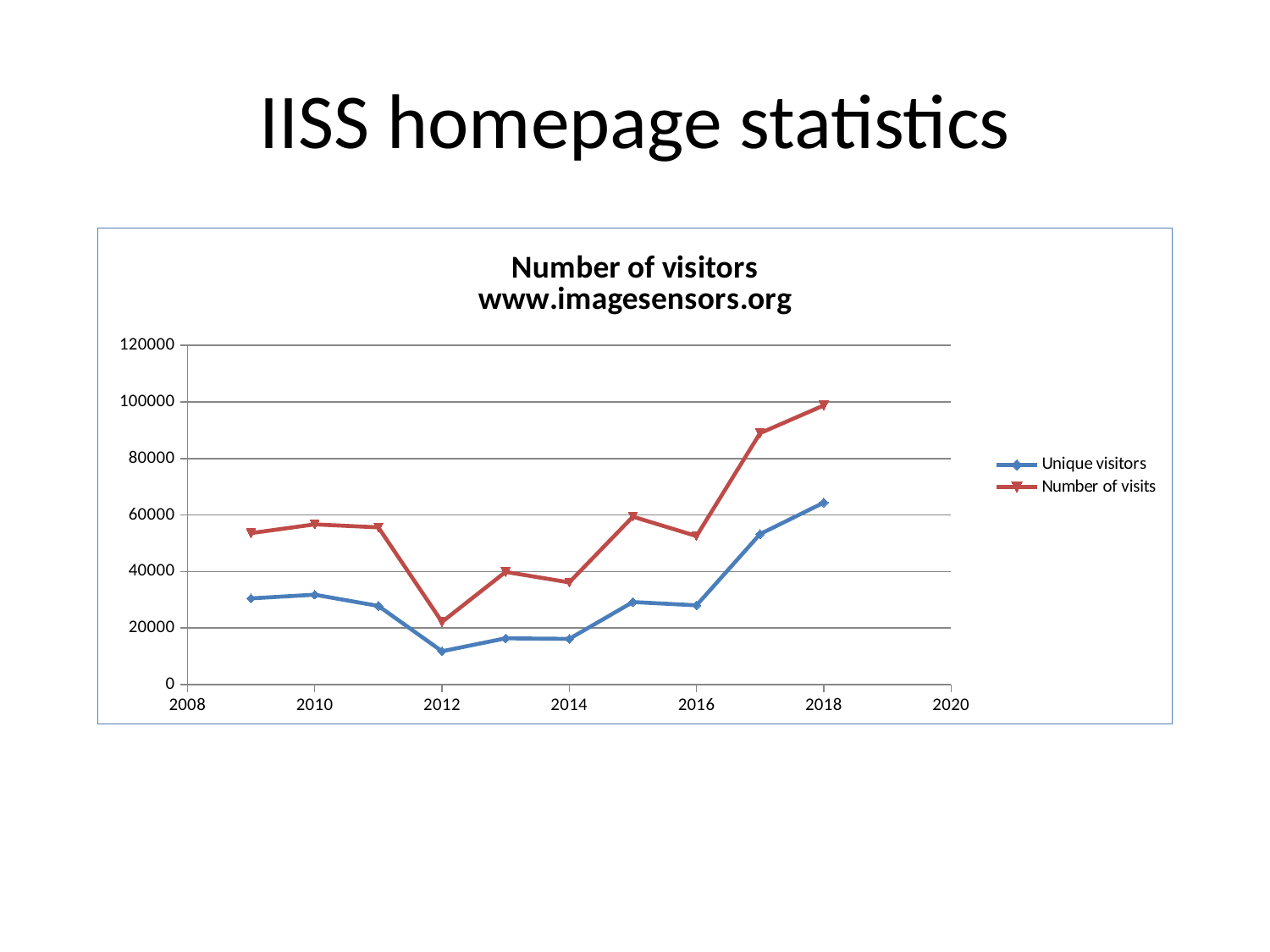
In which year is the Number of visits highest? 2018 Which is larger in 2018, Unique visitors or Number of visits? Number of visits Is the Number of visits value for 2018 greater or less than 80000? greater Is the Unique visitors value for 2012 greater or less than 20000? less Do the Number of visits values rise or fall from 2016 to 2018? rise In which year is the Unique visitors value lowest? 2012 How many data points are plotted for the Number of visits series? 10 What kind of chart is shown on the slide? line chart Which series is drawn in red? Number of visits How many series does the legend list? 2 Is the Number of visits value for 2017 greater or less than 80000? greater What is the title of the chart? Number of visitors www.imagesensors.org